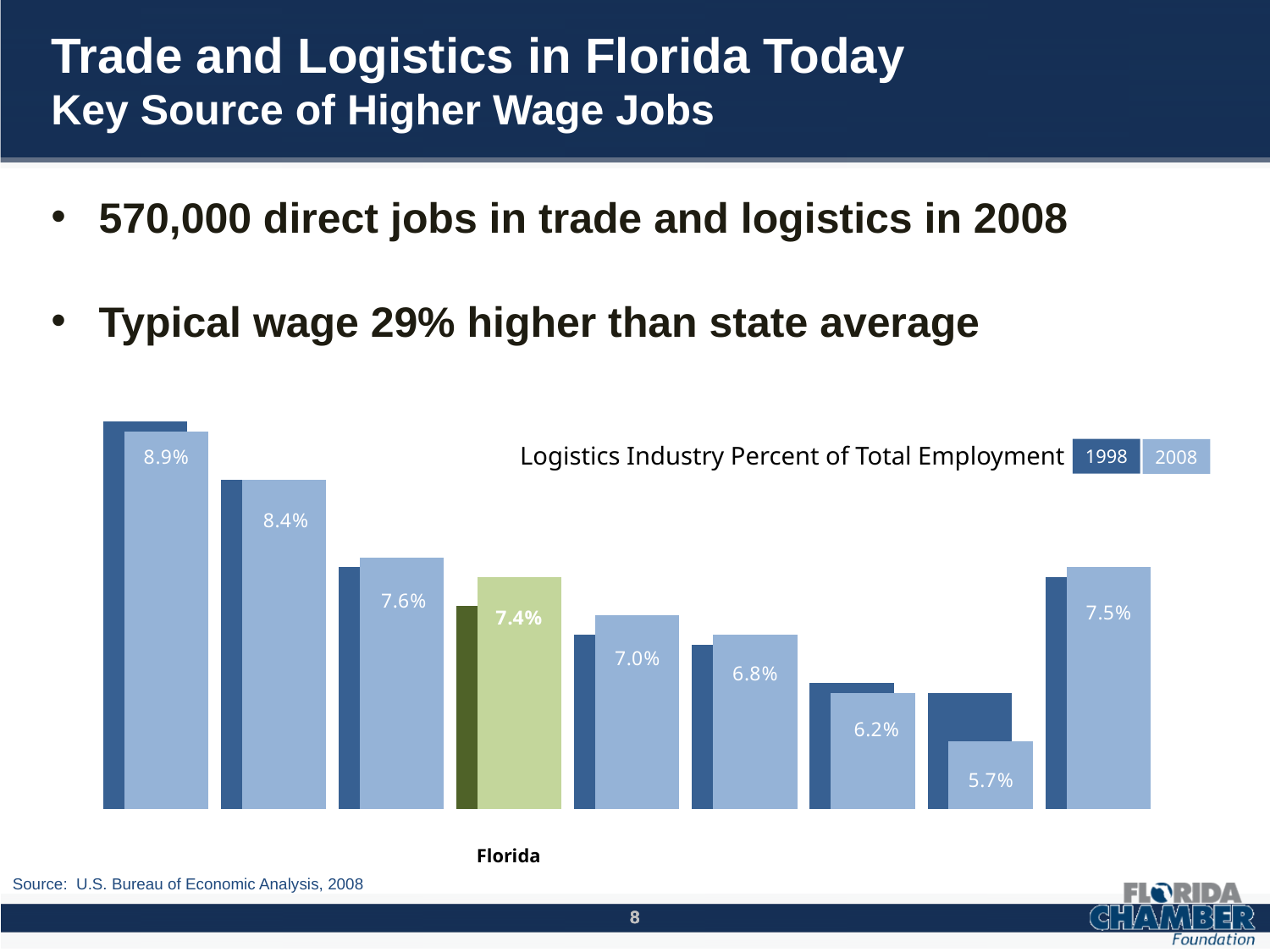
What is the highest 2008 value labeled in the chart? 8.9% How many series does the chart legend list? 2 What is the difference between the lowest 2008 value (5.7%) and Florida's 2008 value (7.4%)? 1.7 percentage points What is the difference between the highest 2008 value (8.9%) and Florida's 2008 value (7.4%)? 1.5 percentage points What is the title of the chart? Logistics Industry Percent of Total Employment What kind of chart is shown on the slide? bar chart What is the 2008 logistics industry percent of total employment for Florida? 7.4% What is the lowest 2008 value labeled in the chart? 5.7% Which years are listed in the chart legend? 1998 and 2008 Which is larger: Florida's 2008 value or the 2008 value of the rightmost category (7.5%)? the rightmost category (7.5%) How many categories (pairs of bars) are shown in the chart? 9 For Florida, is the 2008 bar taller or shorter than the 1998 bar? taller